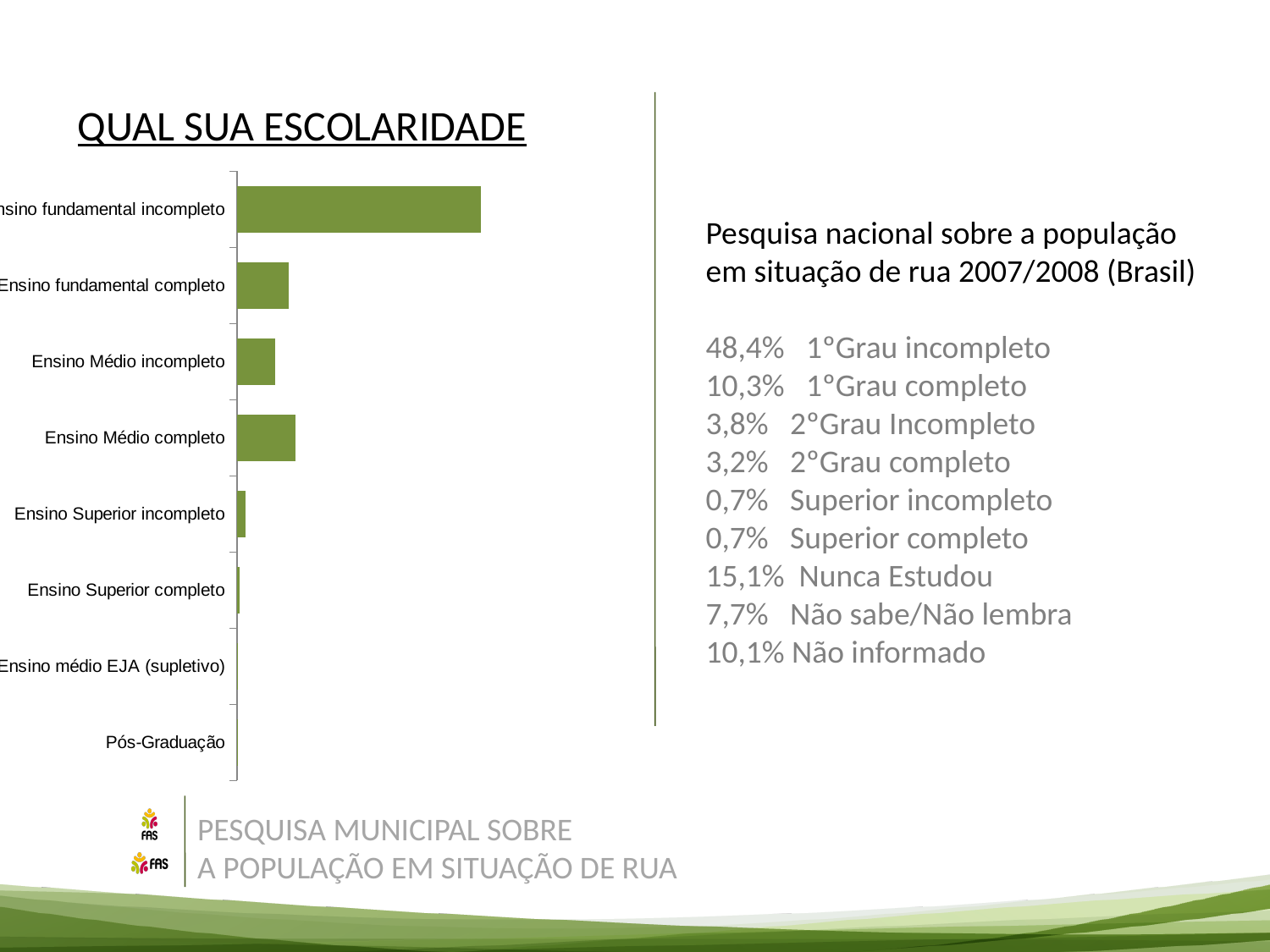
How many categories does the chart show? 8 Which bar is longer: Ensino Médio completo or Ensino Superior incompleto? Ensino Médio completo Which bar is longer: Ensino fundamental incompleto or Ensino fundamental completo? Ensino fundamental incompleto Which bar is longer: Ensino Superior incompleto or Ensino Superior completo? Ensino Superior incompleto Do the bars generally get longer or shorter going from the top category to the bottom category? shorter Which category is listed at the bottom of the chart? Pós-Graduação What is the title of the chart? QUAL SUA ESCOLARIDADE Which category has the longest bar? Ensino fundamental incompleto What kind of chart is shown on the slide? bar chart What colour are the bars in the chart? green